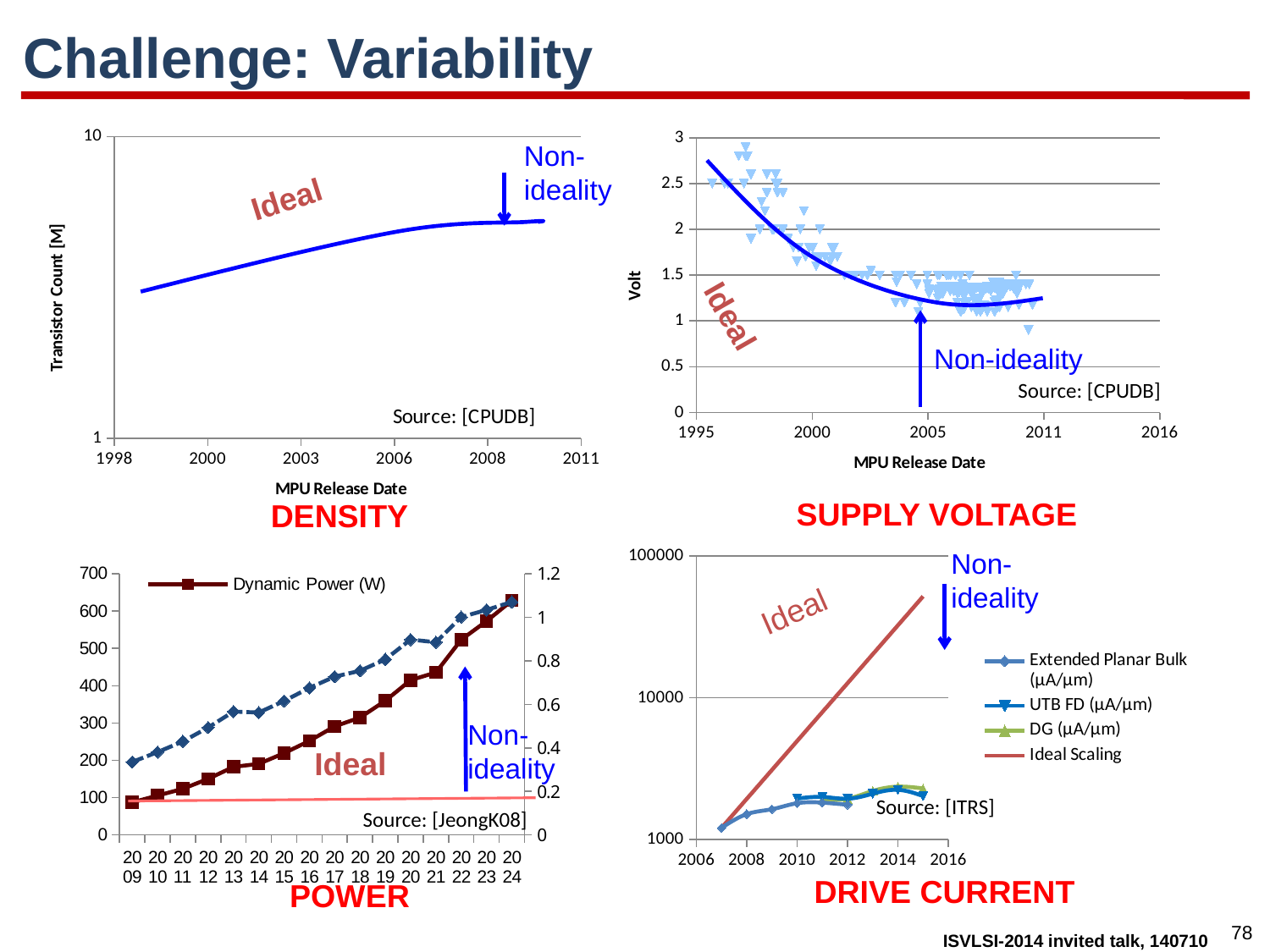
How many charts are shown on the slide? 4 In the POWER chart, what is the name of the series shown in the legend? Dynamic Power (W) In the POWER chart, how many series does the legend list? 1 In the POWER chart, is the Dynamic Power (W) value for 2016 greater or less than 300? less In the DRIVE CURRENT chart, is the Ideal Scaling value for 2015 greater or less than 10000? greater In the POWER chart, does Dynamic Power (W) rise or fall from 2009 to 2024? rise What kind of chart is the DENSITY chart? line chart In the SUPPLY VOLTAGE chart, does the voltage rise or fall as the MPU release date increases? fall In the DRIVE CURRENT chart, how many series does the legend list? 4 In the DRIVE CURRENT chart, does the Ideal Scaling line rise or fall from 2007 to 2015? rise In the POWER chart, is the Dynamic Power (W) value for 2024 greater or less than 600? greater